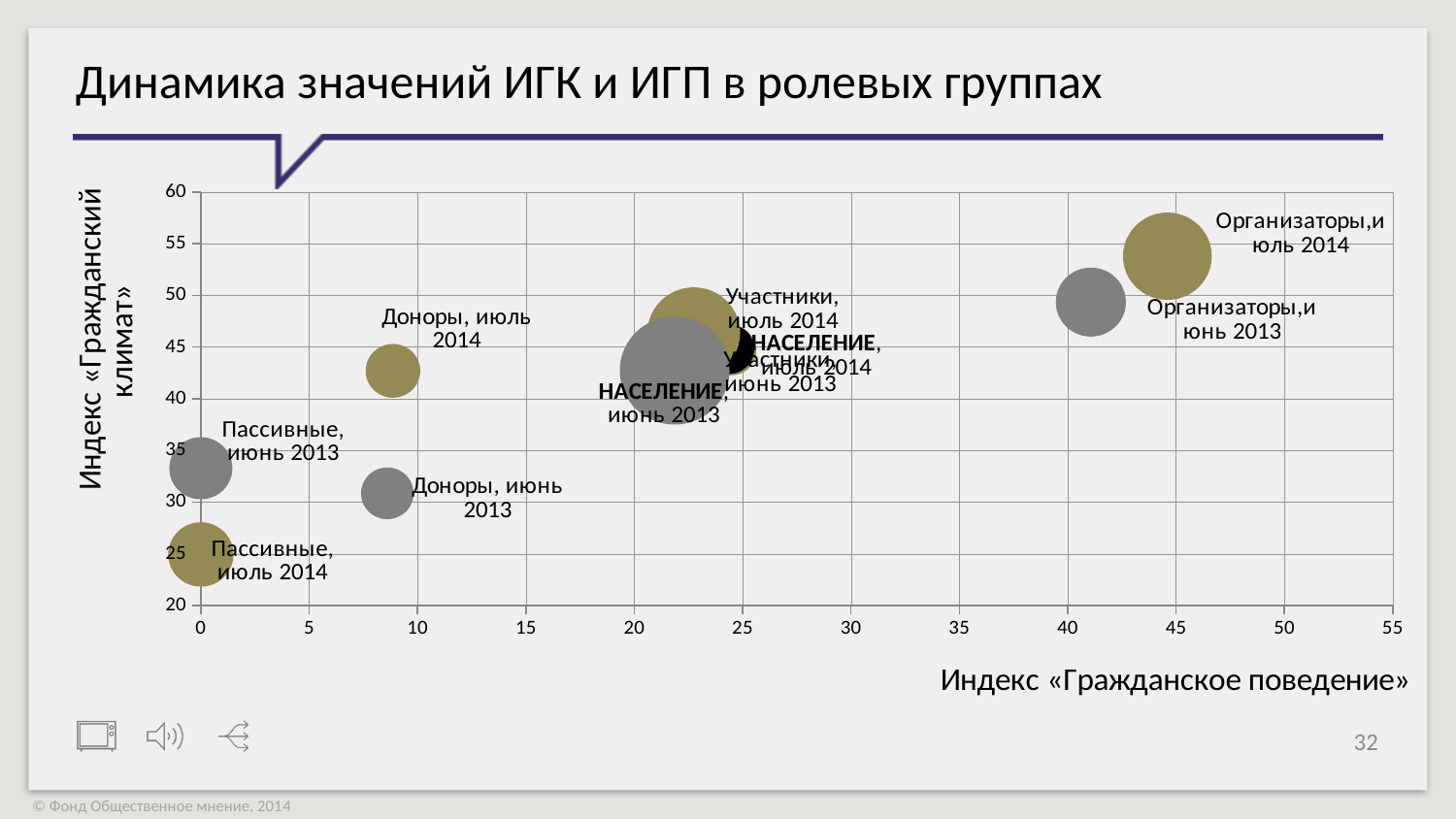
Which bubble has the highest value on the vertical axis (Индекс «Гражданский климат»)? Организаторы, июль 2014 Which has the larger horizontal-axis value: Организаторы, июль 2014 or Организаторы, июнь 2013? Организаторы, июль 2014 What is the title of the chart on the slide? Динамика значений ИГК и ИГП в ролевых группах Is the horizontal-axis value for Доноры, июнь 2013 greater or less than 10? less Is the vertical-axis value for Пассивные, июль 2014 greater or less than 30? less Which has the higher vertical-axis value: Доноры, июль 2014 or Доноры, июнь 2013? Доноры, июль 2014 What kind of chart is shown on the slide? Bubble chart What is the label of the horizontal axis? Индекс «Гражданское поведение» Is the vertical-axis value for Организаторы, июль 2014 greater or less than 50? greater Which bubble has the lowest value on the vertical axis (Индекс «Гражданский климат»)? Пассивные, июль 2014 Which bubble is furthest to the right on the horizontal axis (Индекс «Гражданское поведение»)? Организаторы, июль 2014